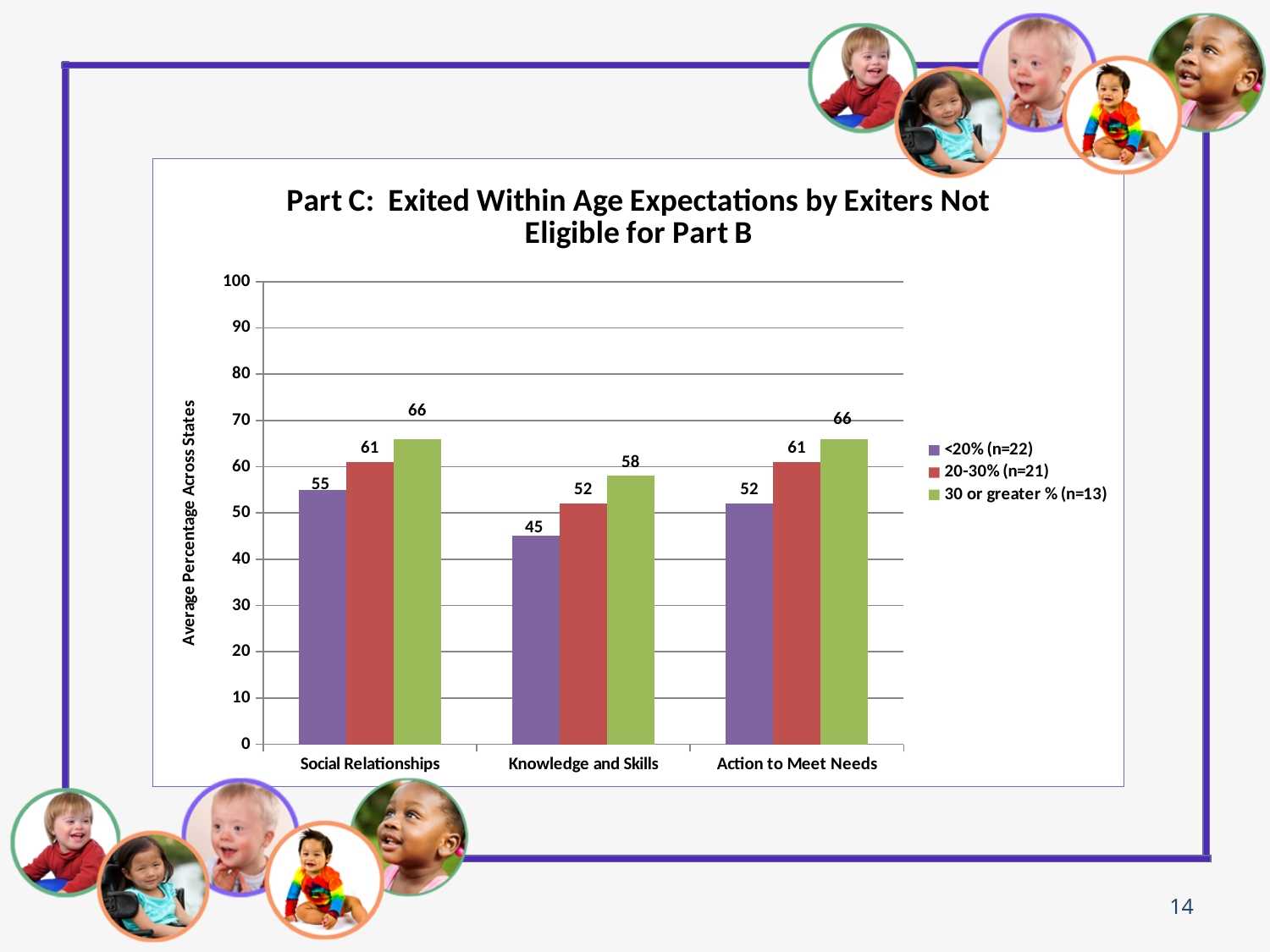
Which category has the lowest value for the <20% (n=22) series? Knowledge and Skills Which is larger: the <20% (n=22) value for Social Relationships or the <20% (n=22) value for Action to Meet Needs? Social Relationships How many categories are shown on the x axis? 3 What kind of chart is shown on the slide? bar chart How many series does the legend list? 3 What is the value for the <20% (n=22) series in the Social Relationships category? 55 What is the difference between the 30 or greater % (n=13) value and the <20% (n=22) value in the Knowledge and Skills category? 13 Is the value for the 20-30% (n=21) series in Knowledge and Skills greater or less than 60? less What is the label of the vertical axis? Average Percentage Across States Which series has the highest value in the Action to Meet Needs category? 30 or greater % (n=13) What is the value for the 20-30% (n=21) series in the Action to Meet Needs category? 61 What is the value for the 30 or greater % (n=13) series in the Knowledge and Skills category? 58